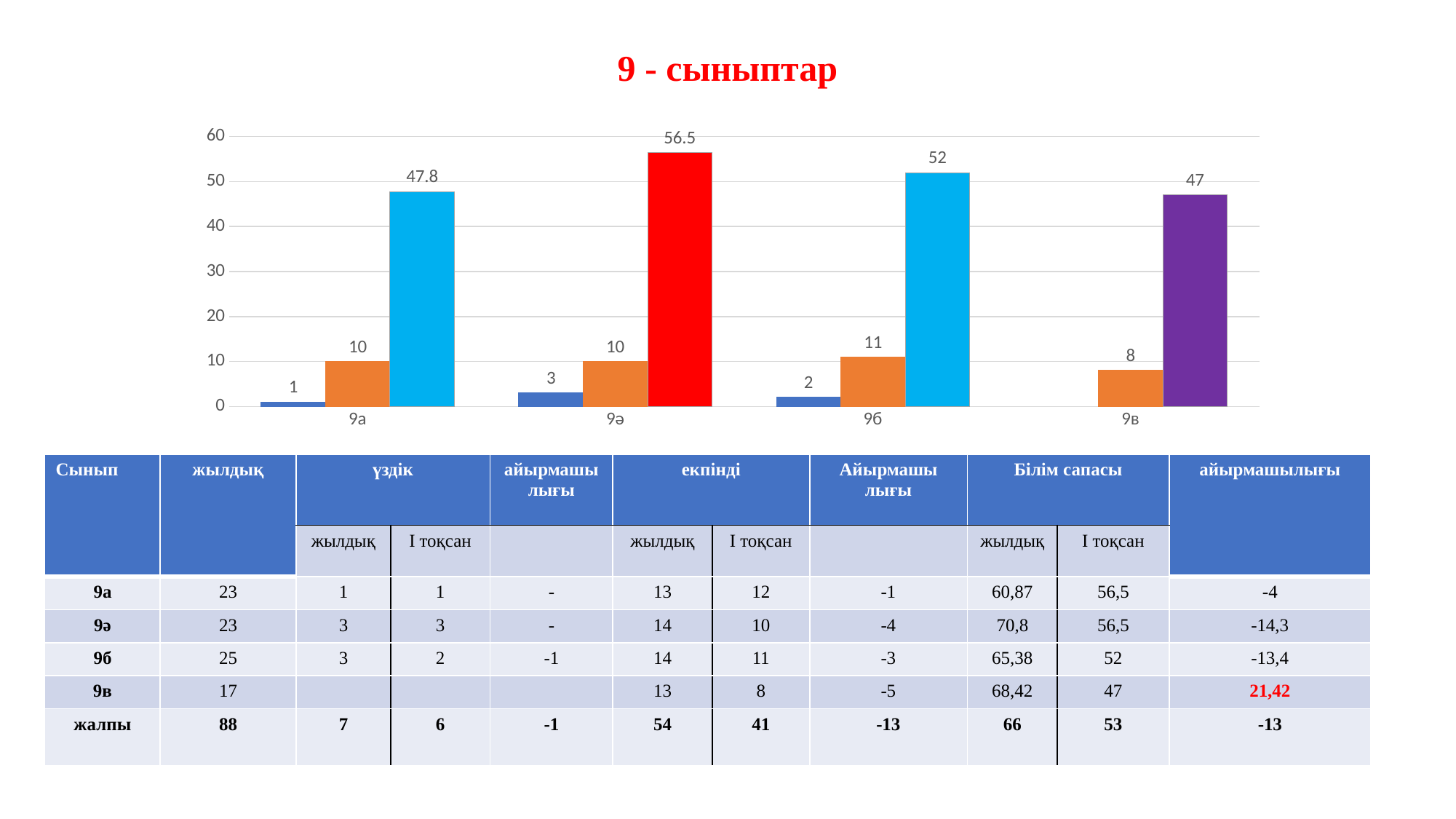
Which category has the highest bar in the chart? 9ә What is the value of the tallest bar in the 9ә group? 56.5 Which is larger: the tallest bar for 9а or the tallest bar for 9в? 9а What is the difference between the tallest bar in the 9ә group (56.5) and the tallest bar in the 9б group (52)? 4.5 What is the value of the orange bar in the 9в group? 8 How many categories are shown on the x axis of the chart? 4 What is the value of the blue (first) bar in the 9ә group? 3 What is the value of the tallest bar in the 9а group? 47.8 What is the value of the orange bar in the 9б group? 11 What is the title of the slide above the chart? 9 - сыныптар What type of chart is shown on the slide? bar chart Which category has the lowest value for the first (blue) bar? 9а